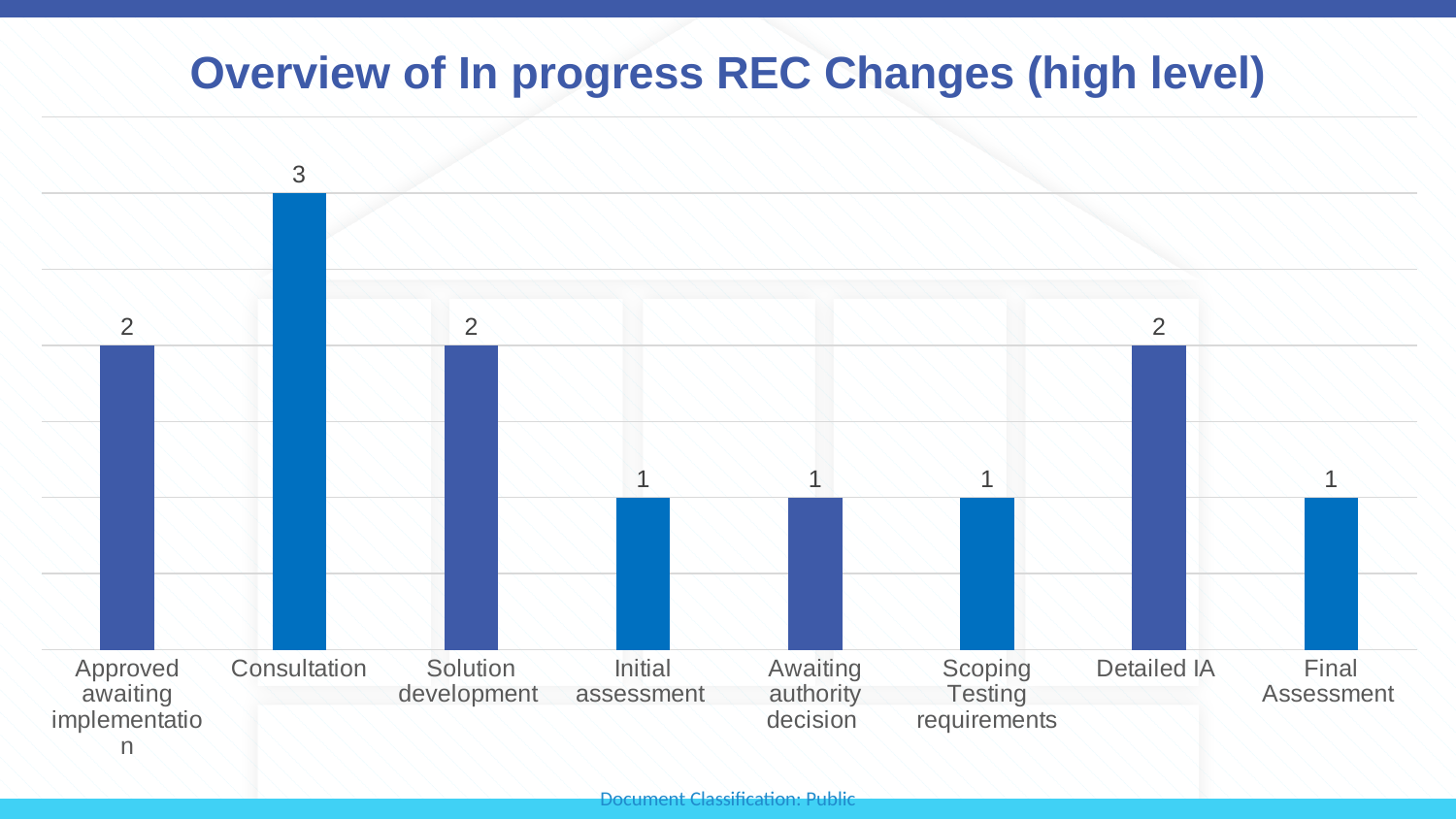
Which category has the highest value? Consultation What is the difference between the values for Consultation and Detailed IA? 1 What is the value for Detailed IA? 2 What is the difference between the values for Consultation and Final Assessment? 2 How many categories have a value of 1? 4 What kind of chart is shown on the slide? Bar chart What is the value for Scoping Testing requirements? 1 What is the value for Consultation? 3 What is the value for Solution development? 2 What is the title of the slide? Overview of In progress REC Changes (high level) How many categories are shown on the x axis? 8 Which is larger, the value for Approved awaiting implementation or the value for Initial assessment? Approved awaiting implementation